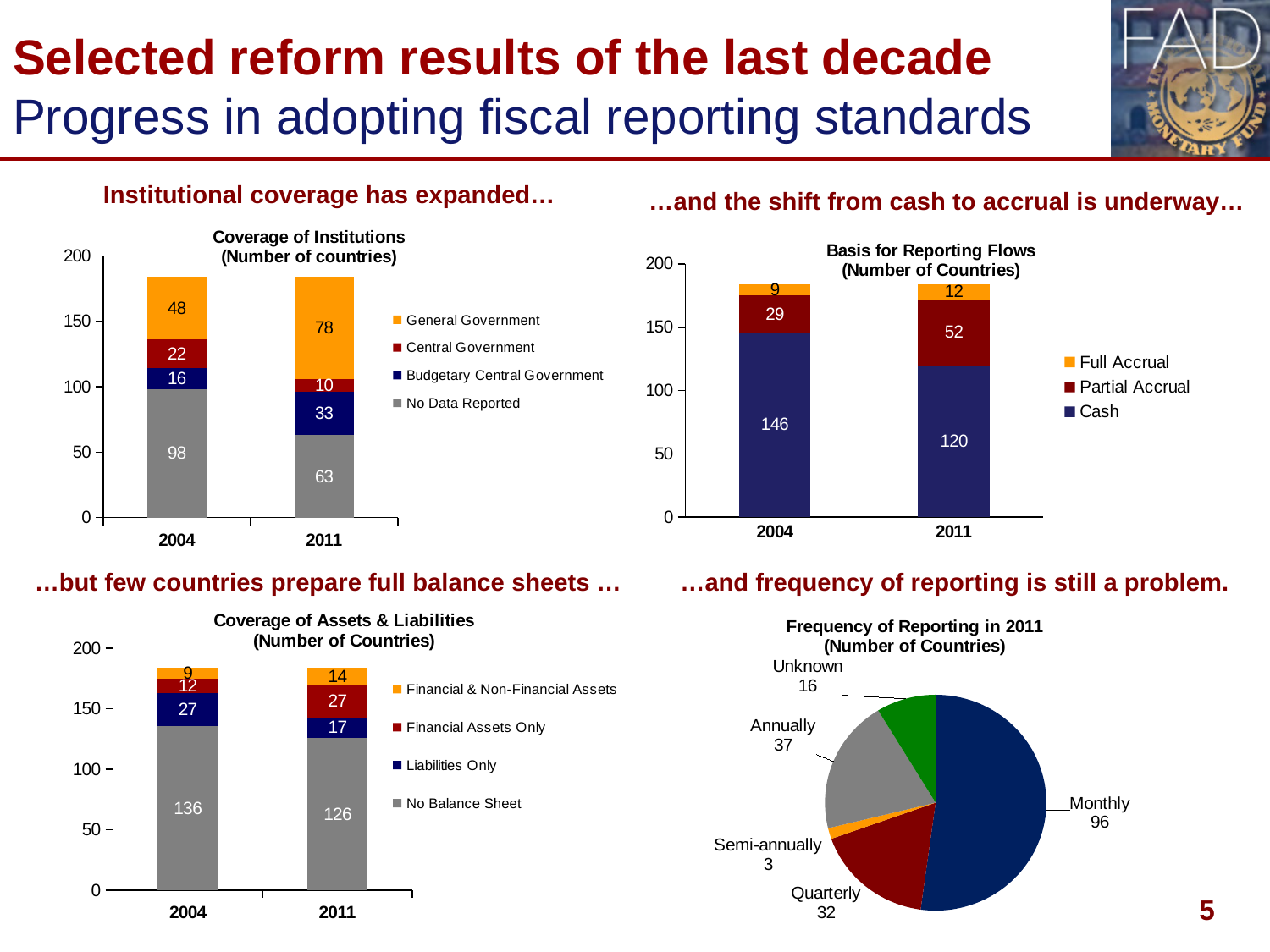
In the 'Coverage of Institutions' chart, what is the total height of the 2004 stacked bar? 184 In the 'Coverage of Institutions' chart, what is the difference between the No Data Reported values for 2004 and 2011? 35 How many categories are shown in the 'Frequency of Reporting in 2011' pie chart? 5 In the 'Coverage of Institutions' chart, how many countries reported General Government coverage in 2011? 78 What kind of chart is 'Frequency of Reporting in 2011'? Pie chart In the 'Frequency of Reporting in 2011' chart, which category has the smallest number of countries? Semi-annually In the 'Basis for Reporting Flows' chart, which is larger: Partial Accrual in 2004 or Partial Accrual in 2011? 2011 In the 'Coverage of Assets & Liabilities' chart, what is the difference between Financial Assets Only in 2011 and in 2004? 15 In the 'Frequency of Reporting in 2011' chart, how many countries report Annually? 37 How many series does the legend of the 'Basis for Reporting Flows' chart list? 3 In the 'Basis for Reporting Flows' chart, how many countries used Cash basis in 2004? 146 In the 'Coverage of Assets & Liabilities' chart, how many countries had Liabilities Only in 2011? 17